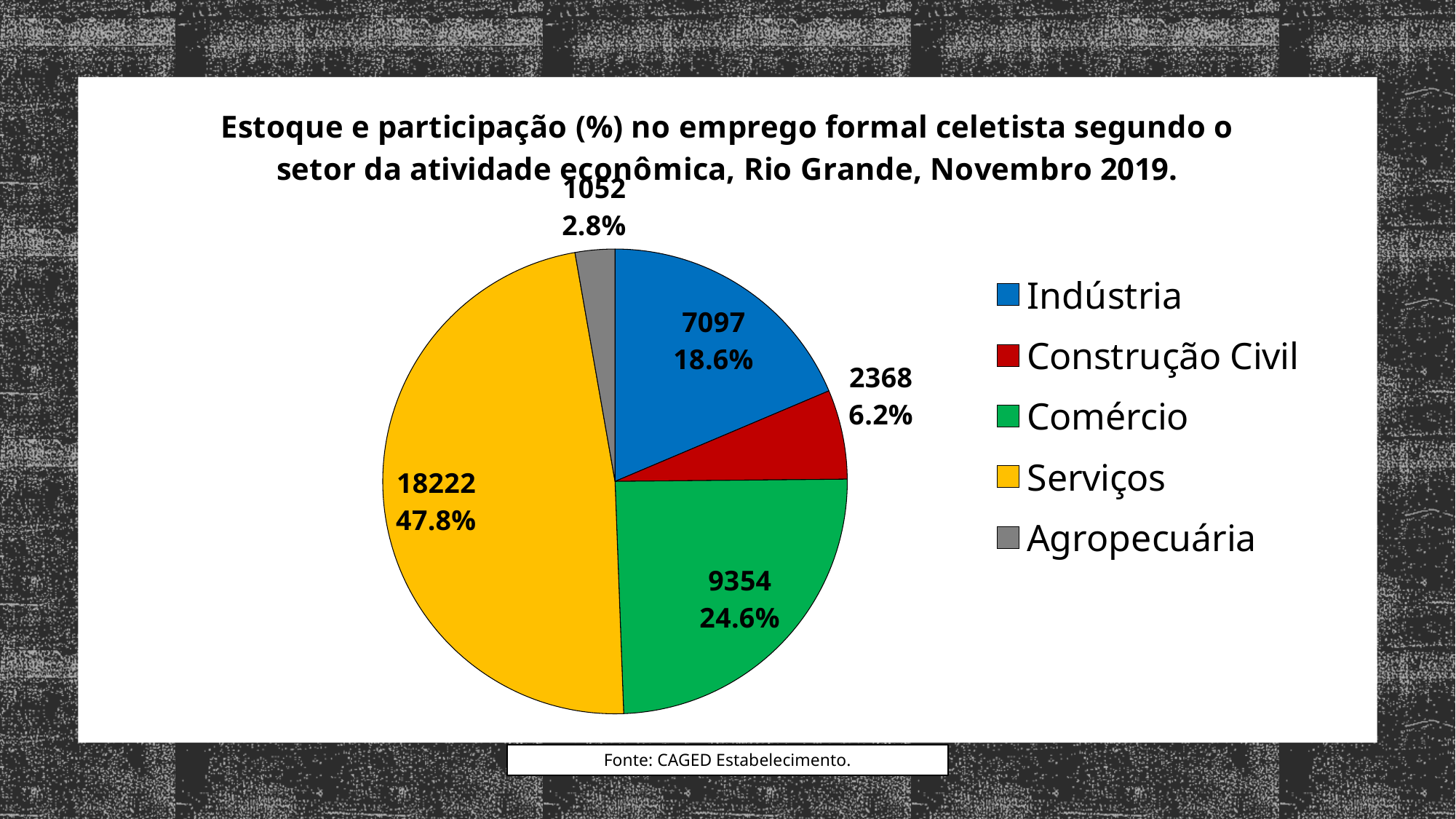
Which sector has the smallest slice? Agropecuária Which sector has the largest slice? Serviços What is the value for Comércio? 9354 What kind of chart is shown on the slide? Pie chart What is the value for Agropecuária? 1052 What percentage share does Construção Civil have? 6.2% How many sectors does the legend list? 5 What percentage share does Serviços have? 47.8% What is the value for Indústria? 7097 Which is larger, the value for Indústria or the value for Construção Civil? Indústria What is the difference between the values for Serviços and Comércio? 8868 What colour is the Comércio slice? Green